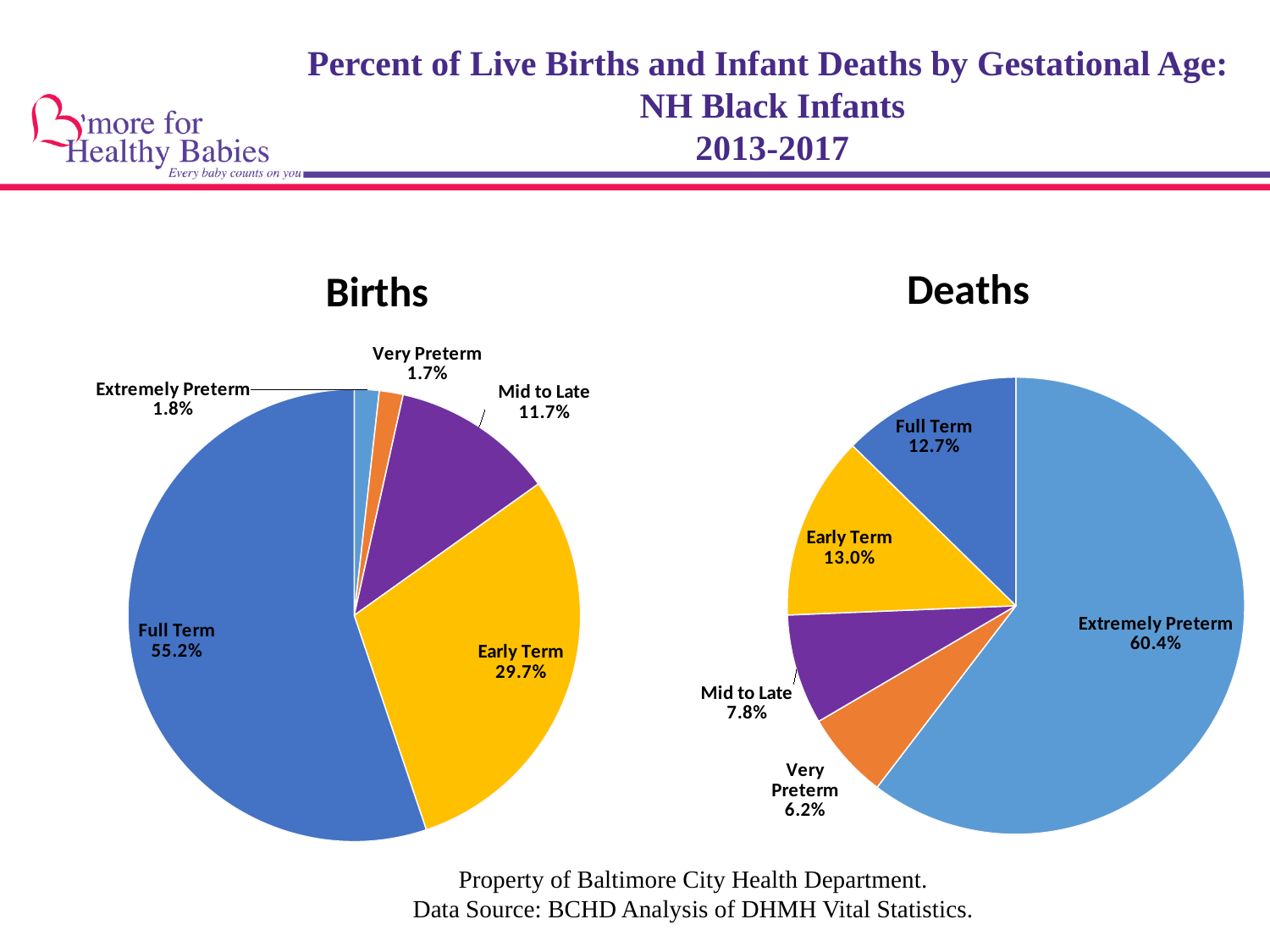
In the Deaths pie chart, what percentage of infant deaths were Extremely Preterm? 60.4% In the Deaths pie chart, what is the difference between the Early Term and Full Term percentages? 0.3% In the Births pie chart, what is the value for Early Term? 29.7% Which is larger: the Extremely Preterm share in the Births chart or the Extremely Preterm share in the Deaths chart? Deaths In the Births pie chart, which category has the smallest share? Very Preterm In the Births pie chart, which category has the largest share? Full Term In the Deaths pie chart, what is the value for Mid to Late? 7.8% How many categories does the Deaths pie chart show? 5 What type of chart is used for the Births chart? Pie chart In the Births pie chart, what percentage of live births were Full Term? 55.2% In the Deaths pie chart, which category has the smallest share? Very Preterm In the Births pie chart, what is the difference between the Full Term and Early Term percentages? 25.5%